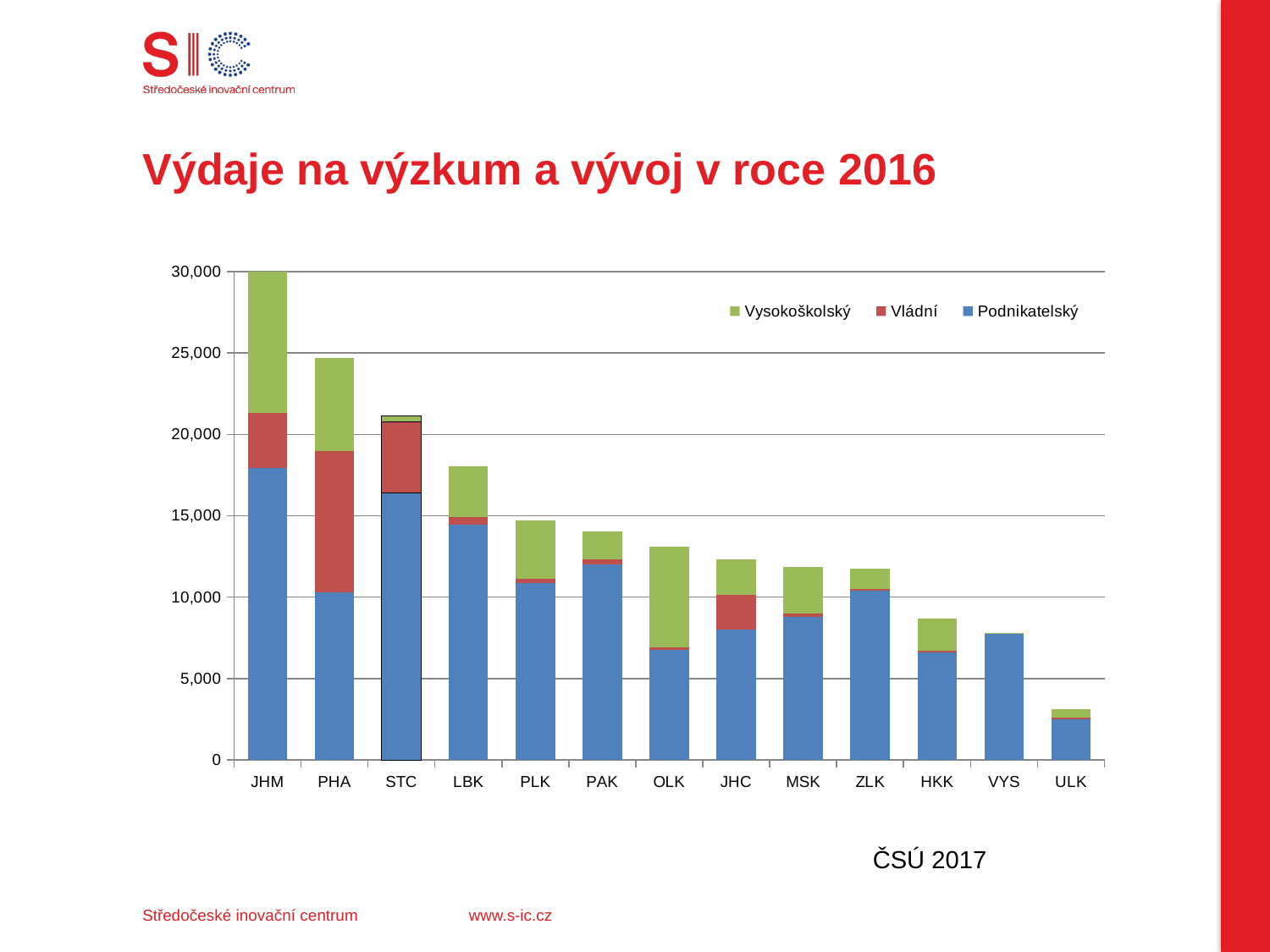
Which category has the lowest total bar? ULK Is the total value for STC greater or less than 20,000? greater Is the Podnikatelský value for JHM greater or less than 15,000? greater What is the title of the chart on the slide? Výdaje na výzkum a vývoj v roce 2016 How many series does the legend list? 3 Is the total value for ULK greater or less than 5,000? less Which has the larger total bar, PHA or STC? PHA Do the total bar values rise or fall from left to right along the x axis? fall How many categories are shown on the x axis? 13 What kind of chart is shown on the slide? bar chart Which category has the highest total bar? JHM